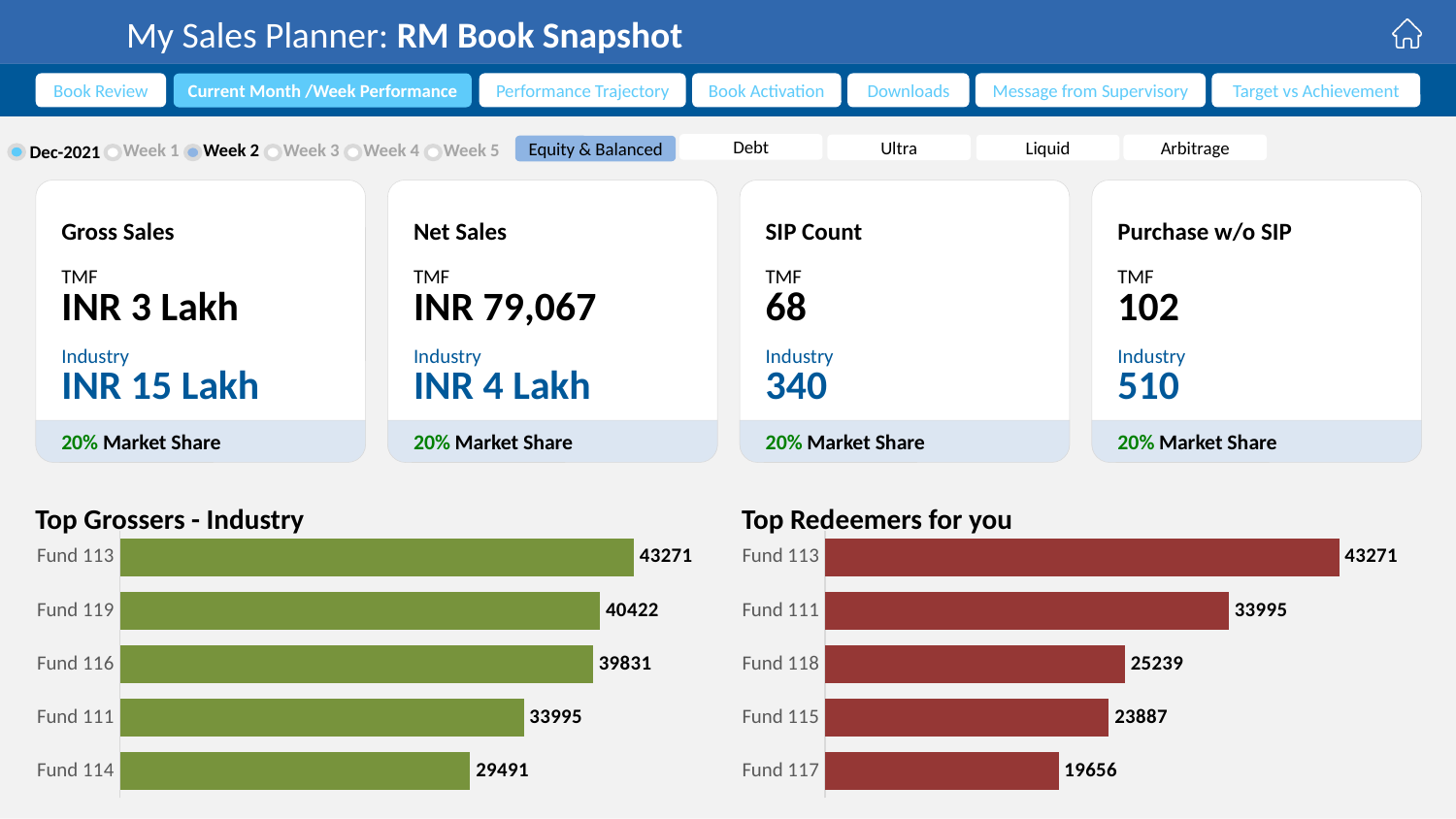
In the Top Grossers - Industry chart, what is the value for Fund 119? 40422 What kind of chart is the Top Redeemers for you chart? Bar chart In the Top Redeemers for you chart, what is the value for Fund 118? 25239 In the Top Redeemers for you chart, which is larger, the value for Fund 111 or the value for Fund 115? Fund 111 In the Top Grossers - Industry chart, what is the difference between the values for Fund 113 and Fund 111? 9276 In the Top Grossers - Industry chart, what is the value for Fund 114? 29491 In the Top Grossers - Industry chart, which fund has the lowest value? Fund 114 In the Top Redeemers for you chart, which fund has the lowest value? Fund 117 In the Top Grossers - Industry chart, how many funds are shown? 5 In the Top Redeemers for you chart, what is the difference between the values for Fund 113 and Fund 111? 9276 In the Top Redeemers for you chart, what is the value for Fund 117? 19656 In the Top Grossers - Industry chart, which fund has the highest value? Fund 113